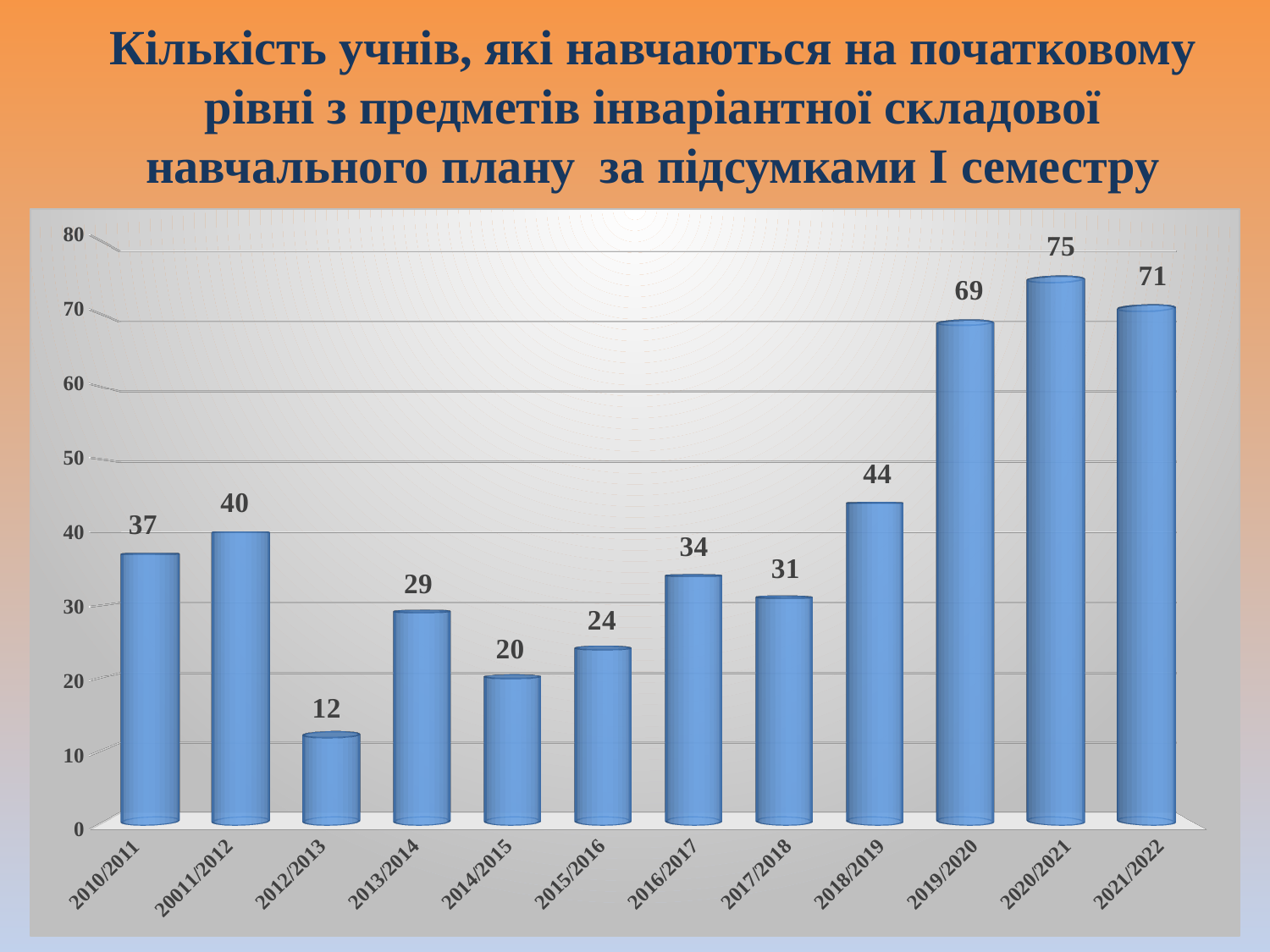
What is the difference between the values for 2020/2021 and 2021/2022? 4 Which is larger, the value for 2010/2011 or the value for 2017/2018? 2010/2011 What kind of chart is shown on the slide? bar chart Do the values generally rise or fall from 2015/2016 to 2020/2021? rise What is the difference between the values for 2018/2019 and 2019/2020? 25 How many categories are shown on the x axis? 12 Which category has the highest value? 2020/2021 What is the value for 2012/2013? 12 What is the value for 2016/2017? 34 Is the value for 2013/2014 greater or less than 30? less What is the value for 2019/2020? 69 Which category has the lowest value? 2012/2013